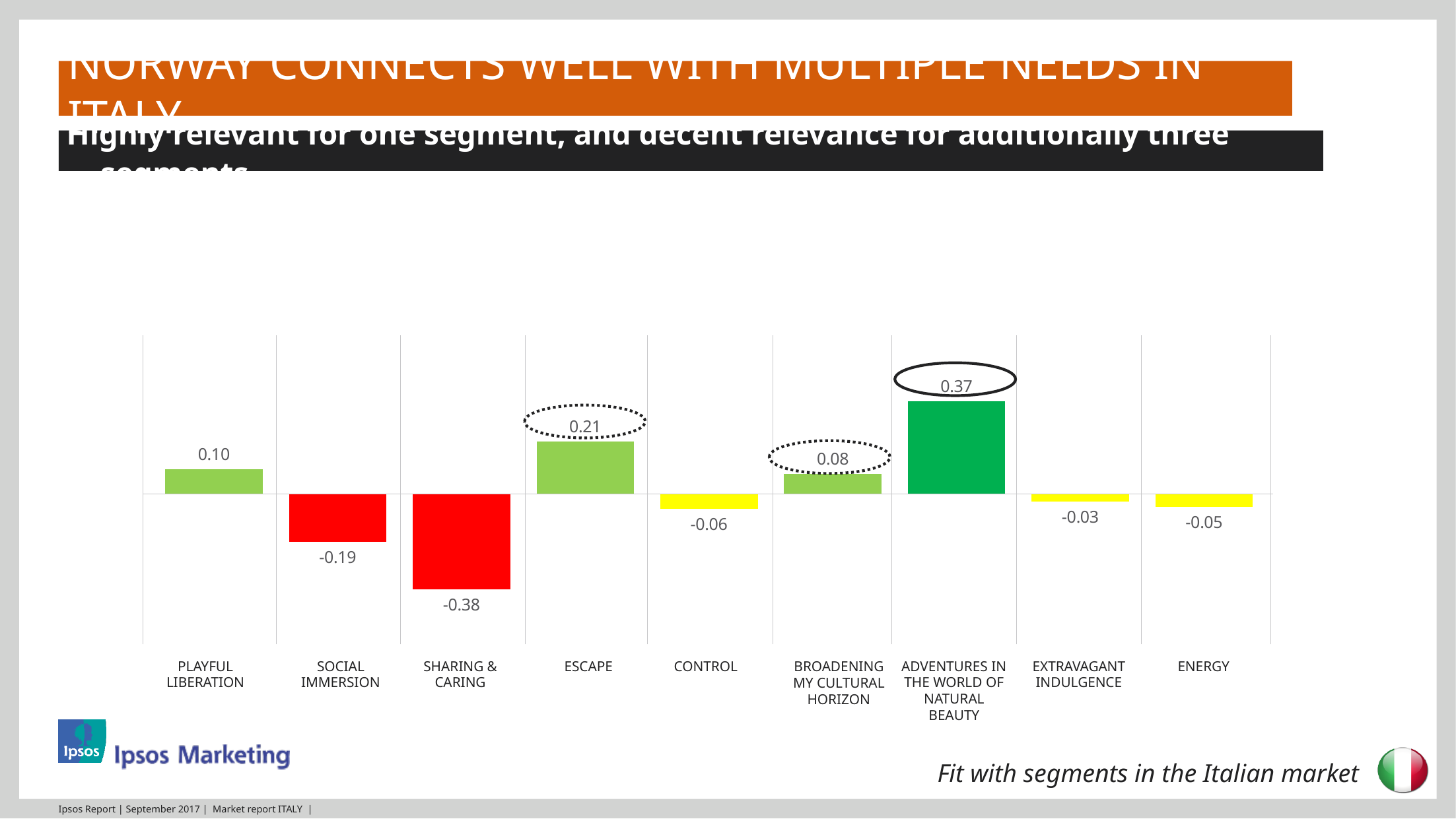
How many categories are shown on the chart? 9 What colour are the bars for SOCIAL IMMERSION and SHARING & CARING? Red Which category's data label is circled with a solid black line? ADVENTURES IN THE WORLD OF NATURAL BEAUTY What is the value for SHARING & CARING? -0.38 What is the difference between the values for ADVENTURES IN THE WORLD OF NATURAL BEAUTY and ESCAPE? 0.16 Which category has the highest value? ADVENTURES IN THE WORLD OF NATURAL BEAUTY What kind of chart is shown on the slide? Bar chart Which is larger, the value for PLAYFUL LIBERATION or the value for BROADENING MY CULTURAL HORIZON? PLAYFUL LIBERATION Which category has the lowest value? SHARING & CARING What is the value for EXTRAVAGANT INDULGENCE? -0.03 What is the value for BROADENING MY CULTURAL HORIZON? 0.08 What is the value for ESCAPE? 0.21